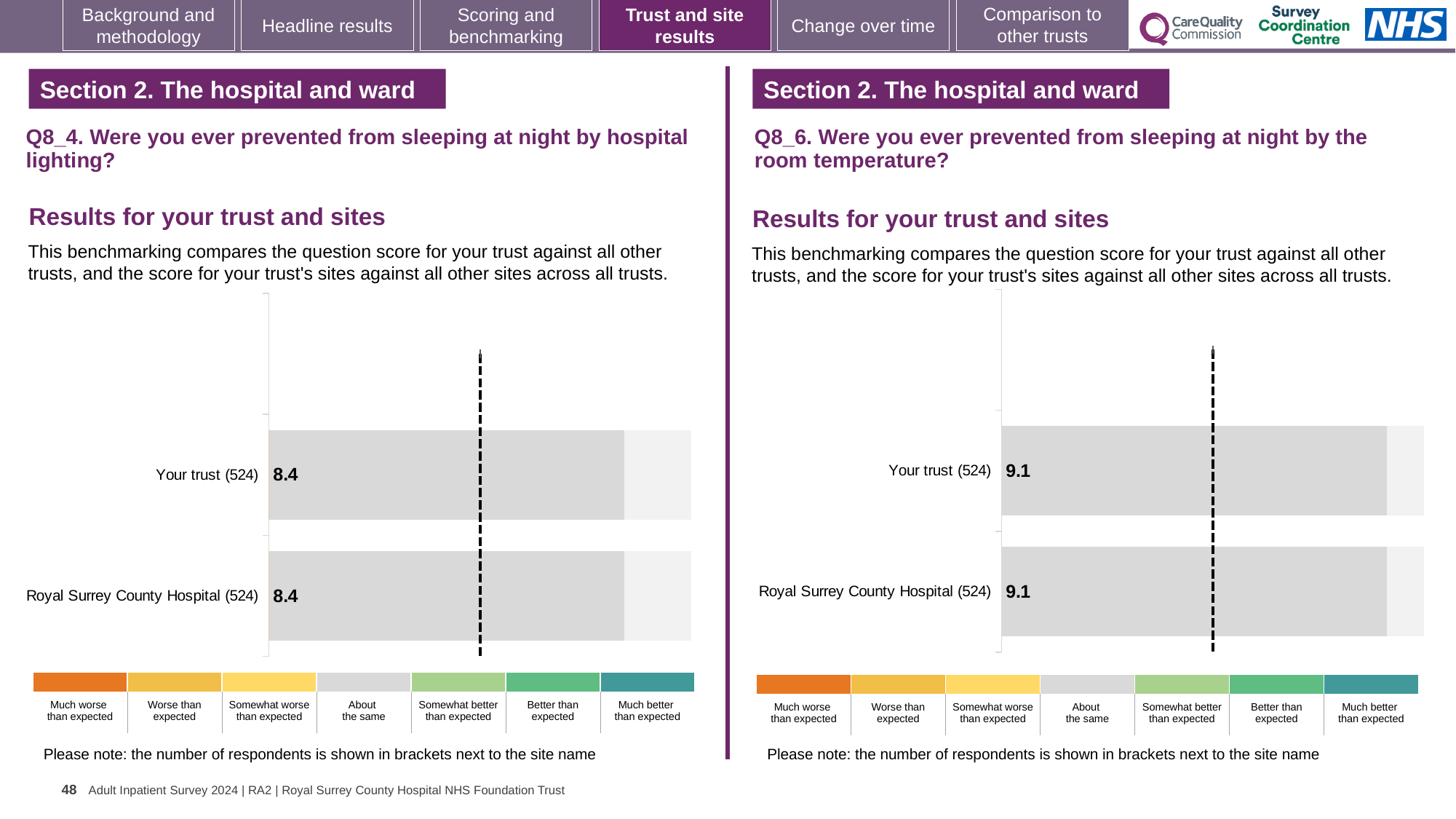
How many benchmark categories does the colour legend below the Q8_4 hospital lighting chart list? 7 What type of chart is used for the Q8_4 hospital lighting results? Bar chart In the Q8_6 room temperature chart, what is the score for Royal Surrey County Hospital (524)? 9.1 In the Q8_6 room temperature chart, what is the score for Your trust (524)? 9.1 How many bars are plotted in the Q8_6 room temperature chart? 2 In the Q8_4 hospital lighting chart, what is the score for Royal Surrey County Hospital (524)? 8.4 In the Q8_4 hospital lighting chart, what is the score for Your trust (524)? 8.4 In the Q8_4 hospital lighting chart, what is the difference between the score for Your trust and the score for Royal Surrey County Hospital? 0.0 How many respondents are shown in brackets for Your trust in the Q8_6 room temperature chart? 524 In the Q8_6 room temperature chart, what is the difference between the score for Your trust and the score for Royal Surrey County Hospital? 0.0 In the Q8_6 room temperature chart, which benchmark category does the grey colour of the bars correspond to in the legend? About the same How many bars are plotted in the Q8_4 hospital lighting chart? 2